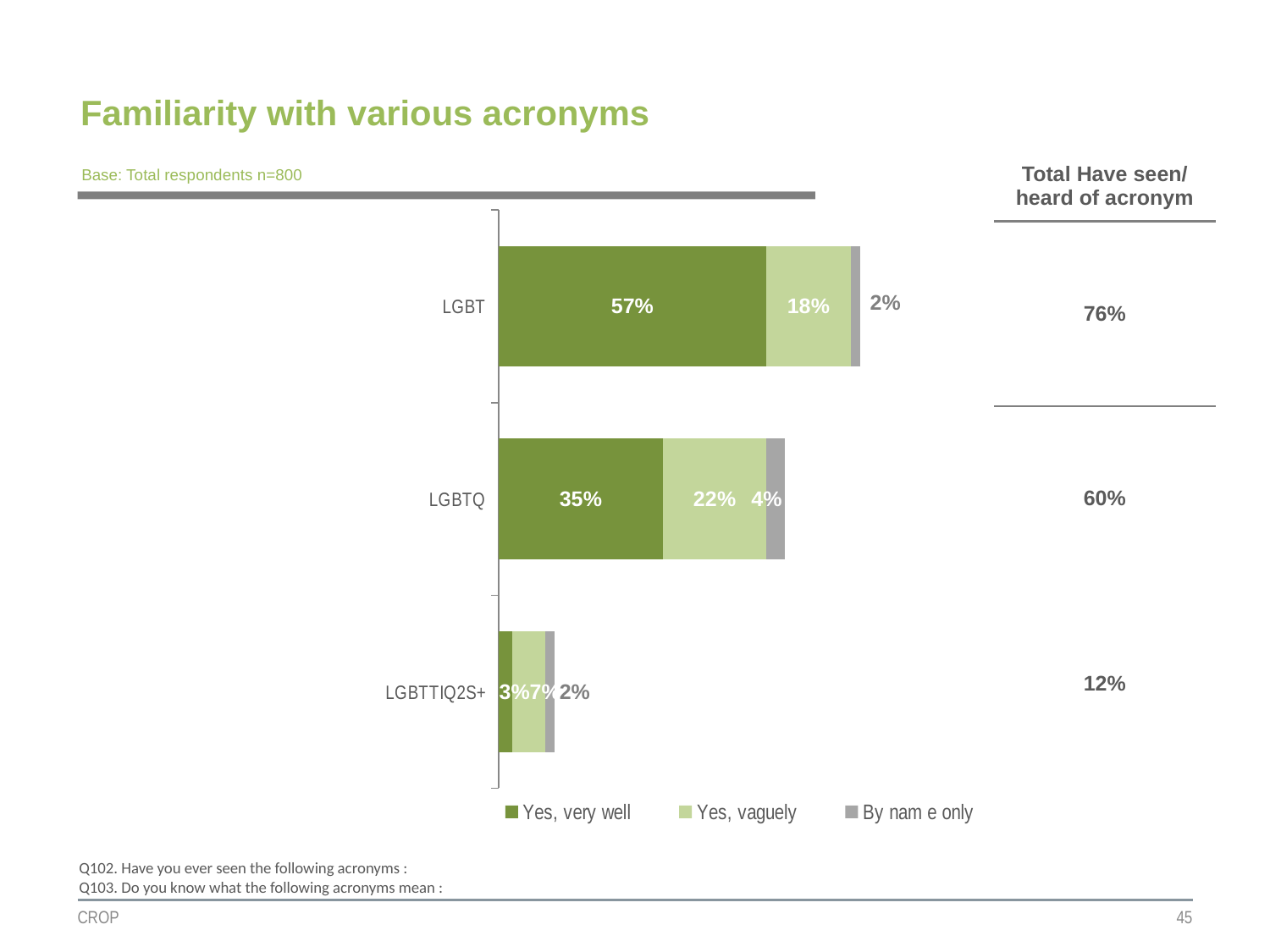
Which acronym has the highest "Yes, very well" value? LGBT What is the total of the stacked bar for LGBTQ? 60% How many acronyms are shown in the chart? 3 What is the title of the chart? Familiarity with various acronyms What percentage of respondents know the acronym LGBT "very well"? 57% What is the difference between the "Yes, very well" values for LGBT and LGBTQ? 22% How many series does the legend list? 3 What is the "By name only" value for LGBTTIQ2S+? 2% Which acronym has the lowest "Yes, vaguely" value? LGBTTIQ2S+ What kind of chart is shown on the slide? Stacked bar chart Which is larger: the "Yes, vaguely" value for LGBT or for LGBTQ? LGBTQ What is the "Yes, vaguely" value for LGBTQ? 22%